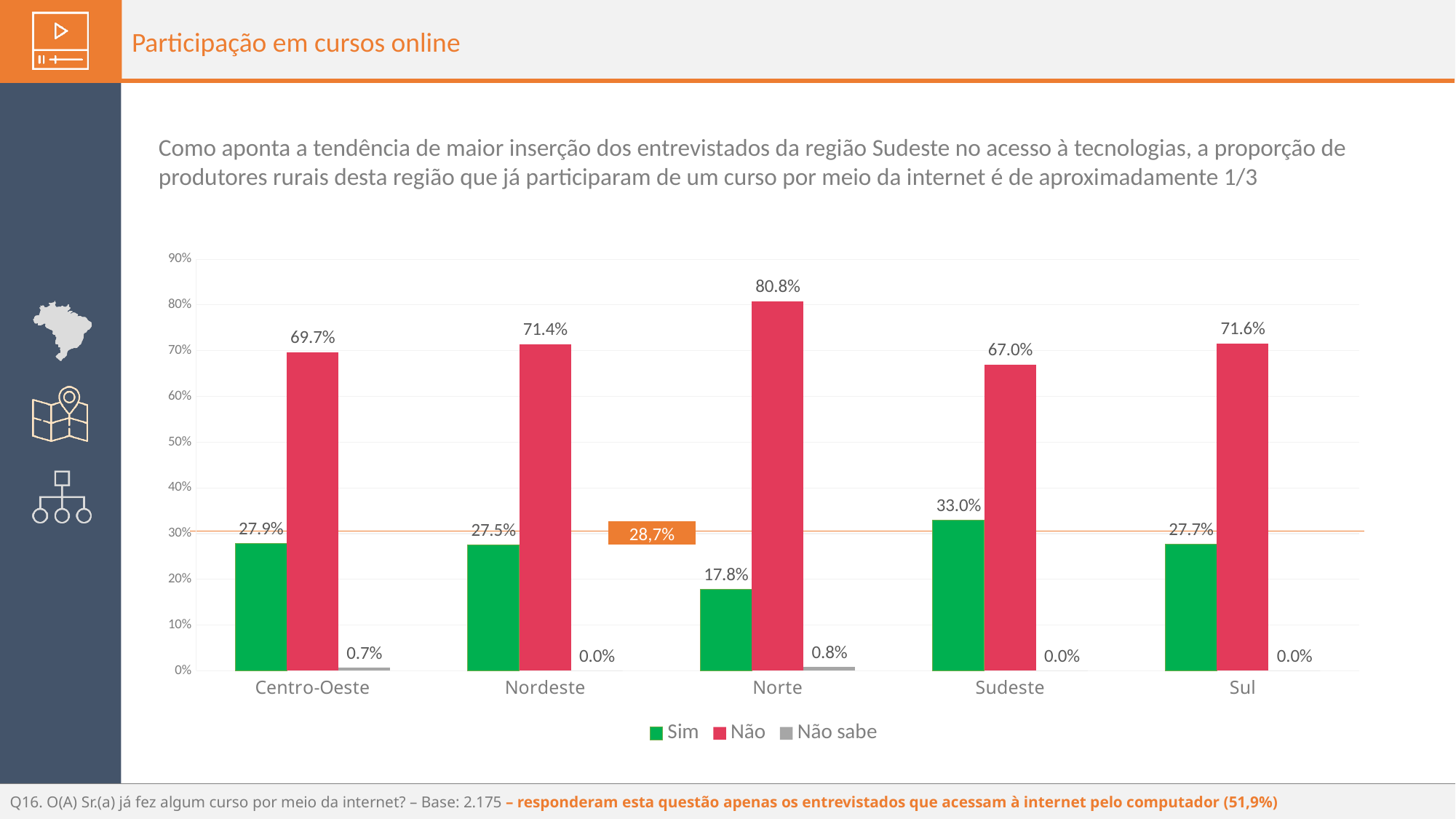
What value is shown in the orange label on the horizontal reference line? 28,7% How many regions are shown on the x axis? 5 What is the difference between the "Não" and "Sim" values for Sul? 43.9% What is the value of the "Não" series for Norte? 80.8% How many series does the legend list? 3 Which region has the lowest "Sim" value? Norte What kind of chart is shown on the slide? Bar chart Which is larger, the "Sim" value for Sudeste or the "Sim" value for Nordeste? Sudeste What is the value of the "Não sabe" series for Centro-Oeste? 0.7% Which region has the highest "Não" value? Norte Is the "Não" value for Sudeste greater or less than 60%? greater What is the value of the "Sim" series for Sudeste? 33.0%